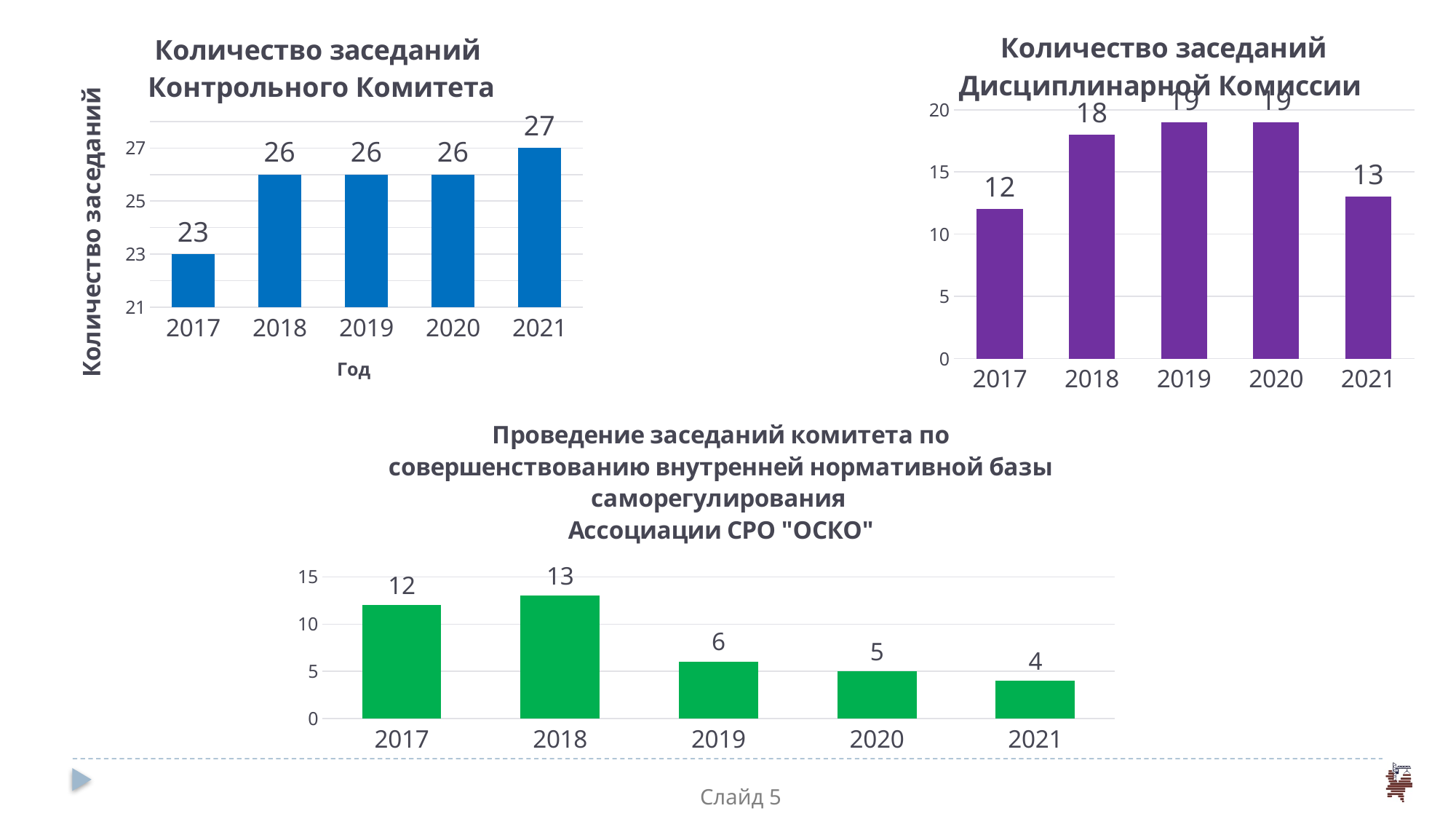
In the chart titled "Количество заседаний Дисциплинарной Комиссии", which is larger, the value for 2018 or the value for 2021? 2018 In the chart titled "Количество заседаний Контрольного Комитета", what is the difference between the values for 2021 and 2017? 4 How many years are shown on the x axis of the chart titled "Количество заседаний Контрольного Комитета"? 5 In the chart titled "Количество заседаний Контрольного Комитета", which year has the highest value? 2021 In the bottom chart (Проведение заседаний комитета по совершенствованию внутренней нормативной базы саморегулирования), do the values rise or fall from 2018 to 2021? fall In the bottom chart (Проведение заседаний комитета по совершенствованию внутренней нормативной базы саморегулирования), which year has the highest value? 2018 In the chart titled "Количество заседаний Дисциплинарной Комиссии", which year has the lowest value? 2017 In the bottom chart (Проведение заседаний комитета по совершенствованию внутренней нормативной базы саморегулирования), what is the value for 2019? 6 In the chart titled "Количество заседаний Контрольного Комитета", what is the value for 2017? 23 In the chart titled "Количество заседаний Дисциплинарной Комиссии", is the value for 2021 greater or less than 15? less In the chart titled "Количество заседаний Дисциплинарной Комиссии", what is the value for 2018? 18 In the bottom chart (Проведение заседаний комитета по совершенствованию внутренней нормативной базы саморегулирования), what is the difference between the values for 2018 and 2021? 9